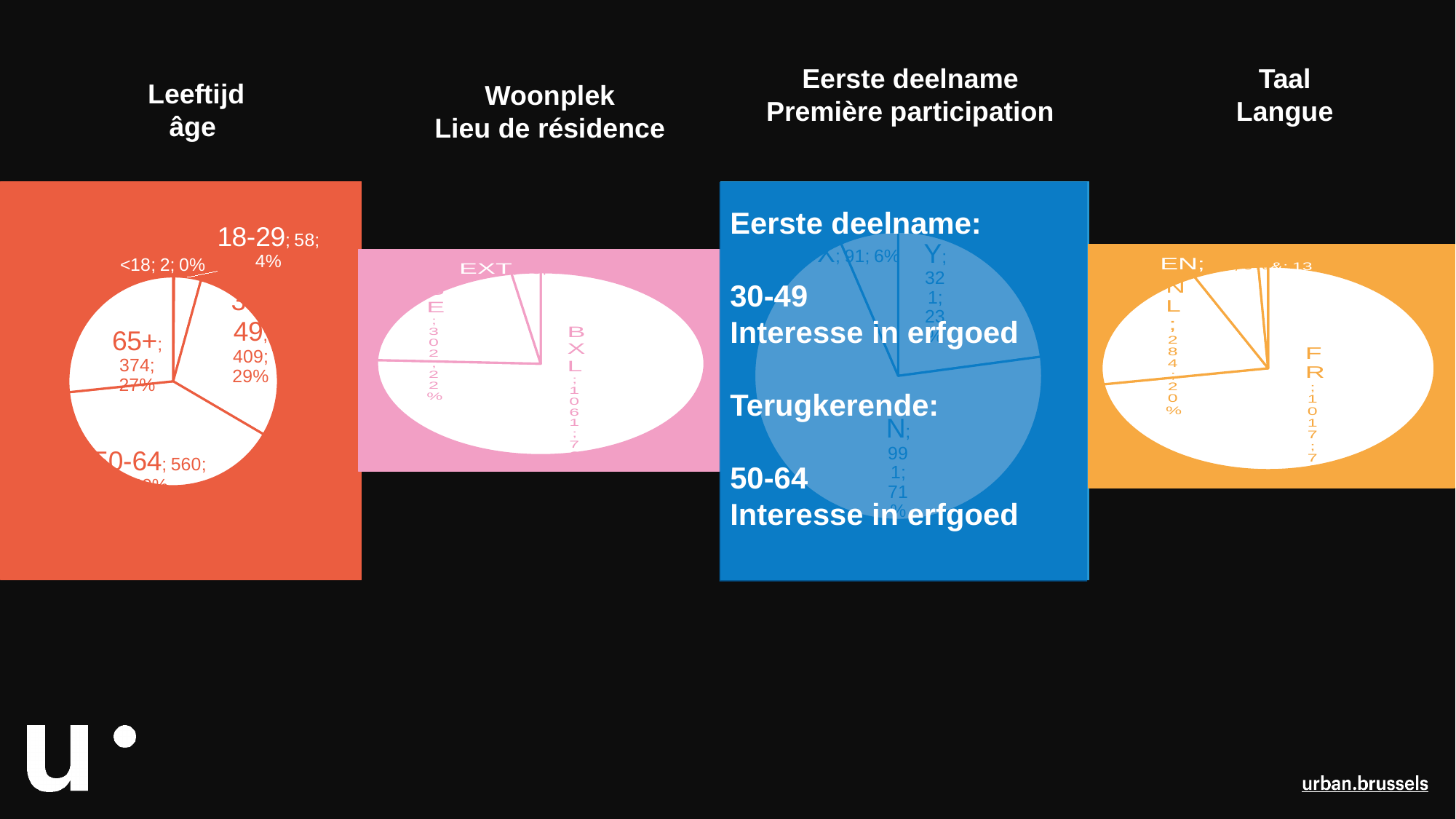
In the Leeftijd / âge chart, what is the difference between the values for 65+ and 18-29? 316 In the Leeftijd / âge chart, what is the value for the 18-29 category? 58 In the Leeftijd / âge chart, which age category has the highest value? 50-64 In the Leeftijd / âge chart, which age category has the lowest value? <18 What kind of chart is shown in the Leeftijd / âge panel? pie chart In the Taal / Langue chart, what is the value for NL? 284 In the Woonplek / Lieu de résidence chart, which is larger, BXL or EXT? BXL In the Leeftijd / âge chart, what is the value for the 65+ category? 374 In the Woonplek / Lieu de résidence chart, what is the value for BXL? 1061 In the Leeftijd / âge chart, what share of the pie does the 65+ slice represent? 27% How many pie charts are shown on the slide? 4